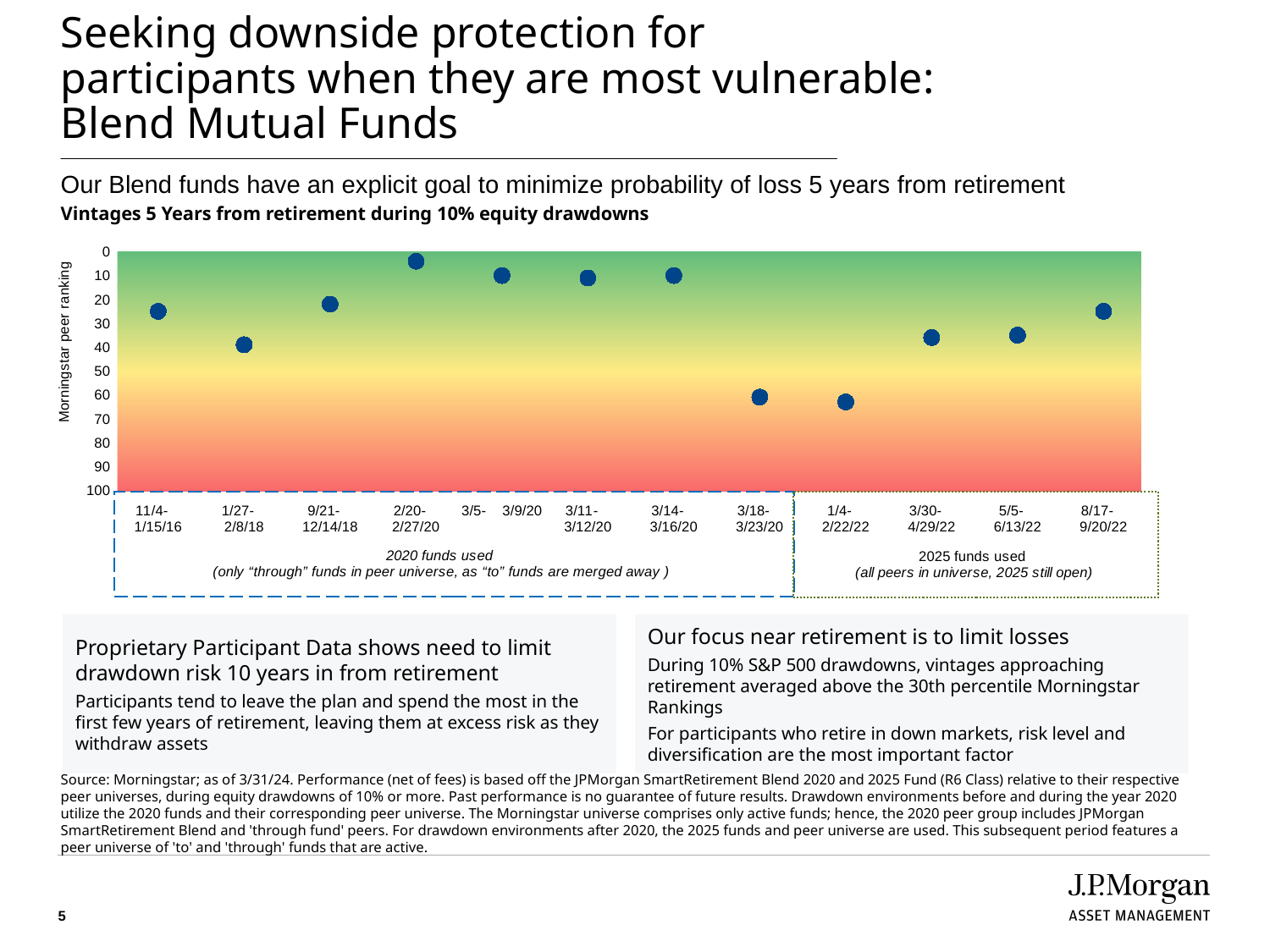
Which has the larger Morningstar peer ranking value, 1/27-2/8/18 or 11/4-1/15/16? 1/27-2/8/18 Which has the larger Morningstar peer ranking value, 3/18-3/23/20 or 3/14-3/16/20? 3/18-3/23/20 Which drawdown period has the lowest Morningstar peer ranking value (closest to 0)? 2/20-2/27/20 Is the Morningstar peer ranking for 11/4-1/15/16 greater or less than 50? less Is the Morningstar peer ranking for 1/4-2/22/22 greater or less than 50? greater How many data points are plotted in the chart? 12 Is the Morningstar peer ranking for 3/18-3/23/20 greater or less than 50? greater What is the label of the vertical axis of the chart? Morningstar peer ranking What kind of chart is shown on the slide? Scatter (dot) chart What is the title of the chart? Vintages 5 Years from retirement during 10% equity drawdowns